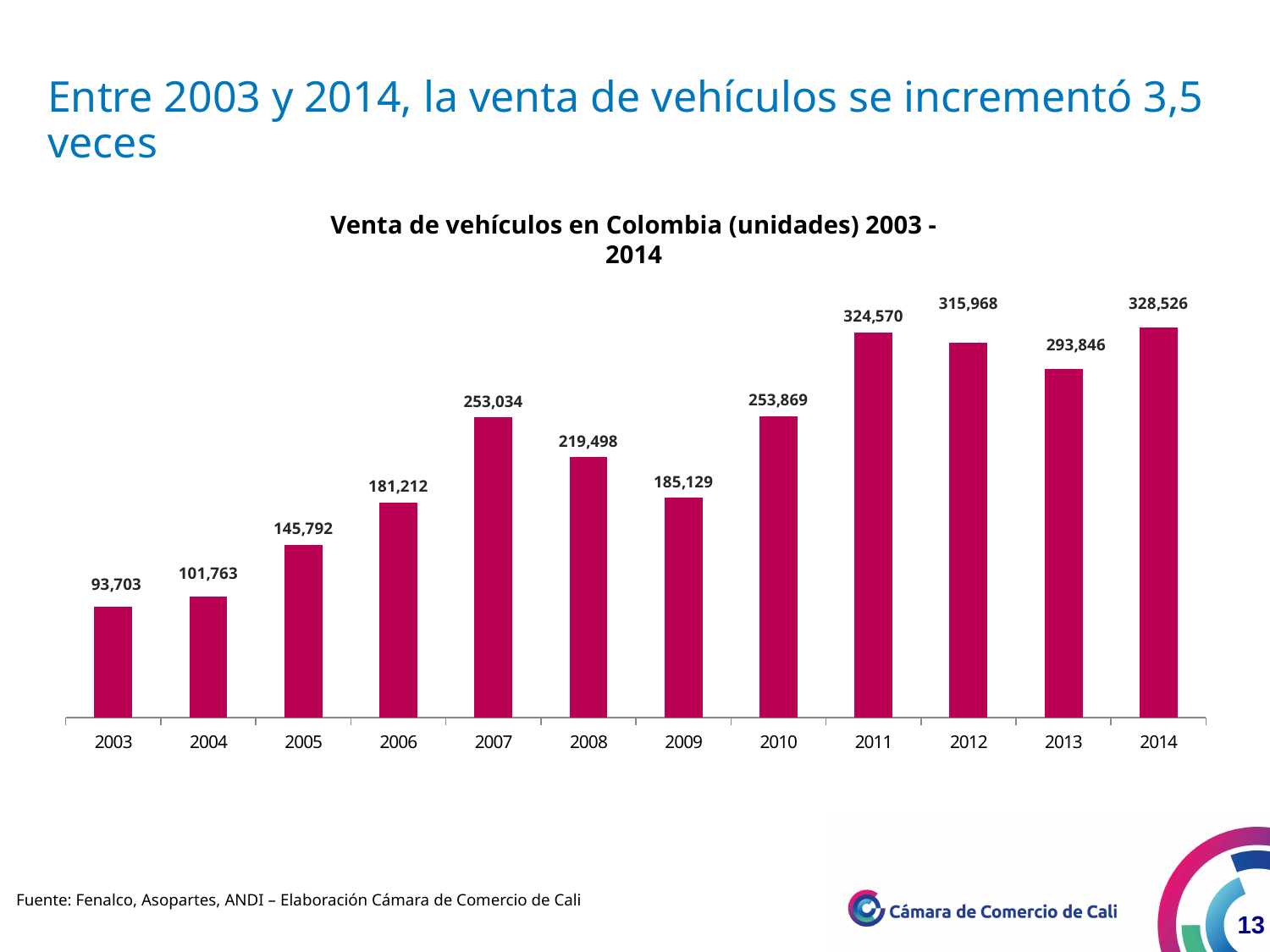
By how much did the value increase from 2010 to 2011? 70,701 Which year has the highest value in the chart? 2014 What kind of chart is shown on the slide? Bar chart How many years are shown on the x axis of the chart? 12 What is the difference between the values for 2014 and 2003? 234,823 What value is shown for 2013? 293,846 Which year has the larger value, 2008 or 2009? 2008 Which year has the larger value, 2012 or 2013? 2012 What was the value for 2007 in the chart? 253,034 What is the title of the chart? Venta de vehículos en Colombia (unidades) 2003 - 2014 Which year has the lowest value in the chart? 2003 How many vehicle units were sold in 2011 according to the chart? 324,570